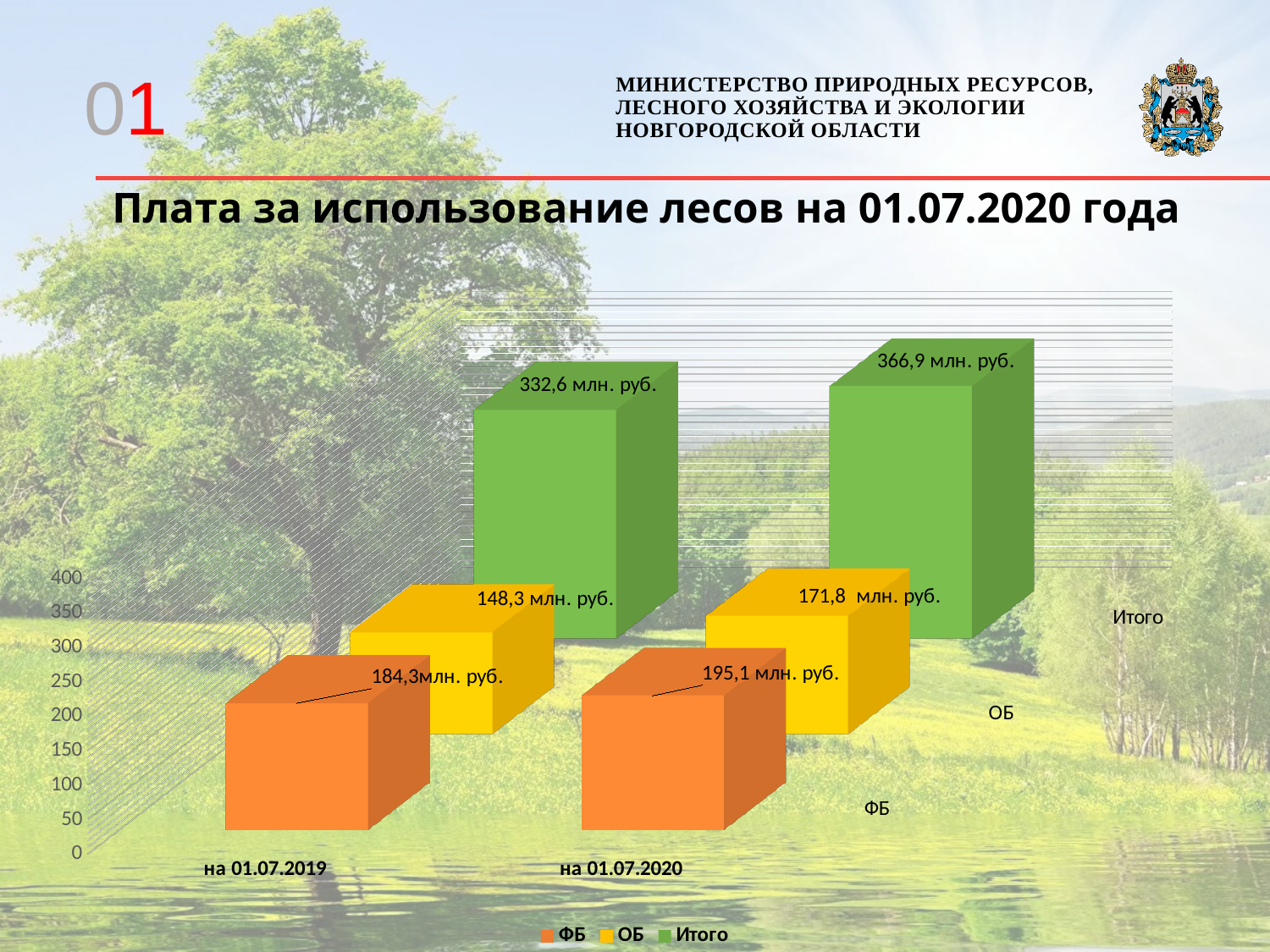
Which is larger: ФБ on 01.07.2019 or ФБ on 01.07.2020? ФБ on 01.07.2020 Which series has the highest value on 01.07.2020? Итого How many series does the legend list? 3 What is the value for ОБ on 01.07.2020? 171,8 млн. руб. What is the title of the chart on the slide? Плата за использование лесов на 01.07.2020 года What is the value for Итого on 01.07.2020? 366,9 млн. руб. What is the difference between ОБ on 01.07.2020 and ОБ on 01.07.2019? 23,5 млн. руб. What is the value for Итого on 01.07.2019? 332,6 млн. руб. What is the value for ФБ on 01.07.2019? 184,3 млн. руб. Which series has the lowest value on 01.07.2019? ОБ By how much did Итого increase from 01.07.2019 to 01.07.2020? 34,3 млн. руб. What kind of chart is shown on the slide? Bar chart